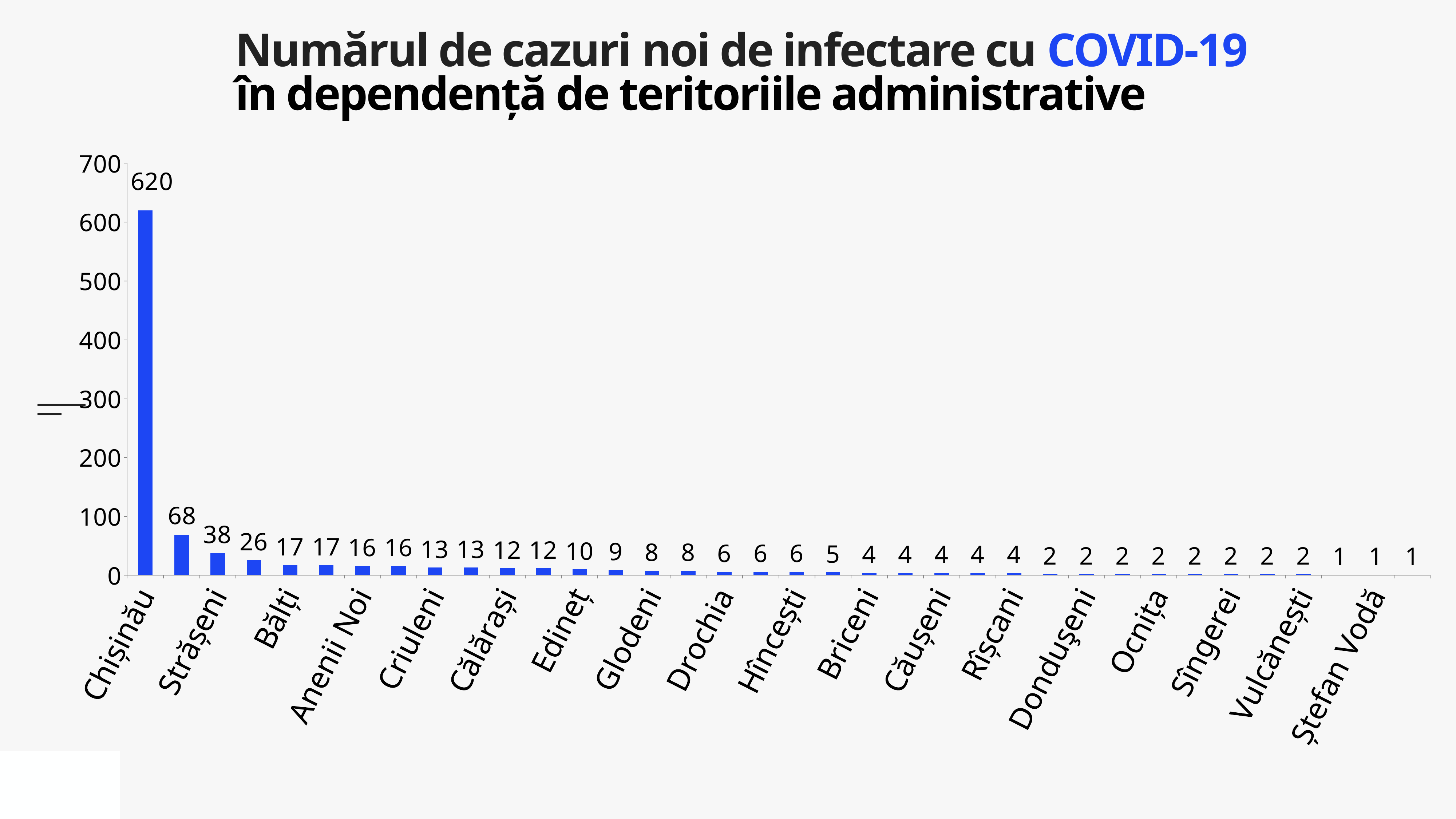
What is the difference between the values for Chișinău and Ștefan Vodă? 619 What is the value for Ștefan Vodă? 1 What is the second highest value shown on the chart? 68 What type of chart is shown on the slide? bar chart Do the values rise or fall from left to right along the x axis? fall What is the value for Chișinău? 620 Which territory has the highest number of new cases? Chișinău What is the highest tick value on the vertical axis? 700 Is the value for Chișinău greater or less than 600? greater What is the lowest value shown on the chart? 1 Which is larger, the value for Chișinău or the value for Ștefan Vodă? Chișinău What is the highest value shown on the chart? 620